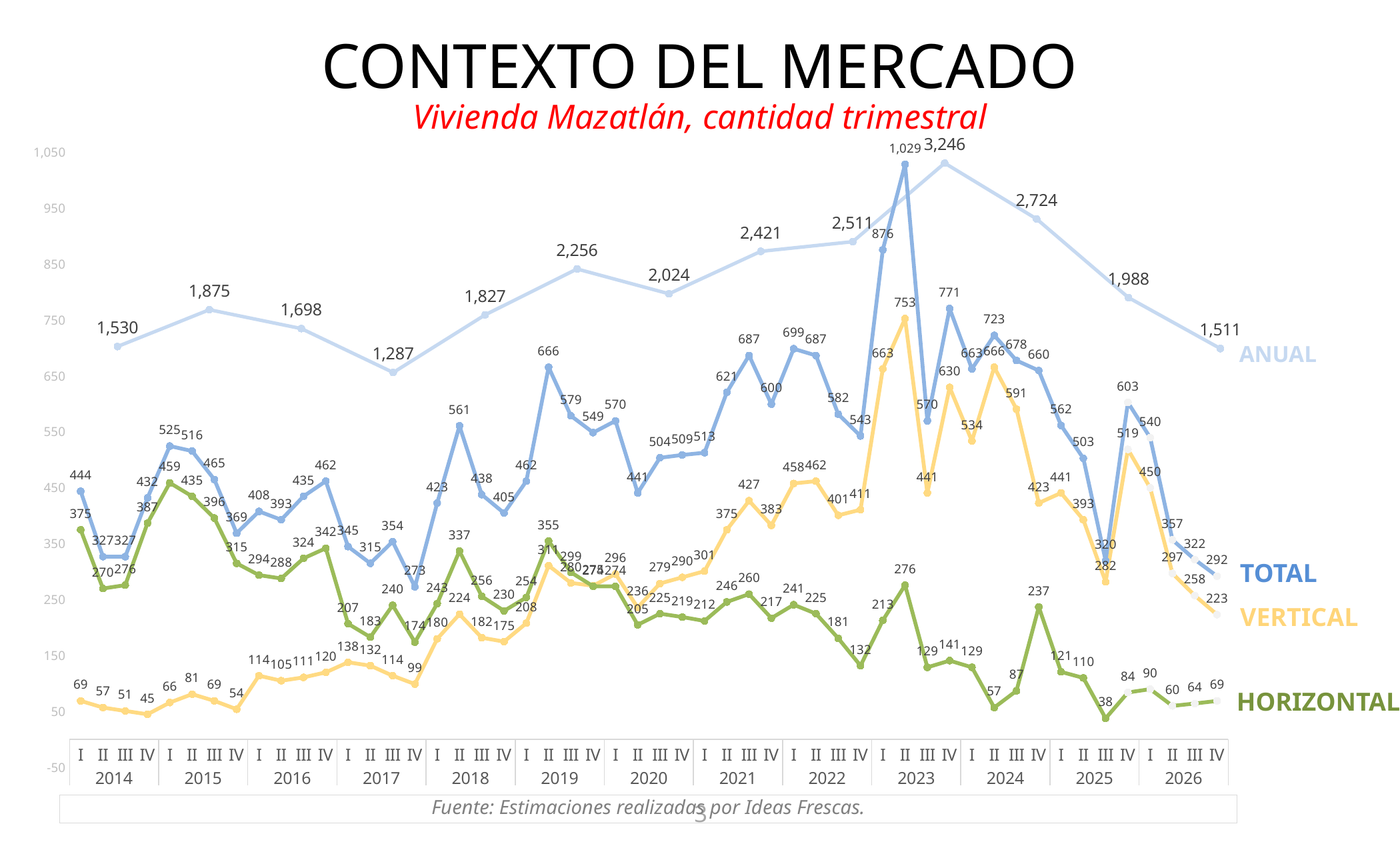
What is the highest value of the HORIZONTAL series? 459 What is the difference between the ANUAL values for 2023 and 2024? 522 What is the HORIZONTAL value in quarter III of 2025? 38 What is the highest value of the TOTAL series, and in which quarter does it occur? 1,029 in 2023 II Which is larger, the ANUAL value for 2015 or for 2018? 2015 (1,875) What kind of chart is shown on the slide? Line chart In which year is the ANUAL series lowest? 2017 What is the VERTICAL value in quarter II of 2023? 753 How many years are shown on the x axis? 13 What is the ANUAL value for 2023? 3,246 Does the ANUAL series rise or fall from 2023 to 2026? Fall How many series are plotted on the chart? 4